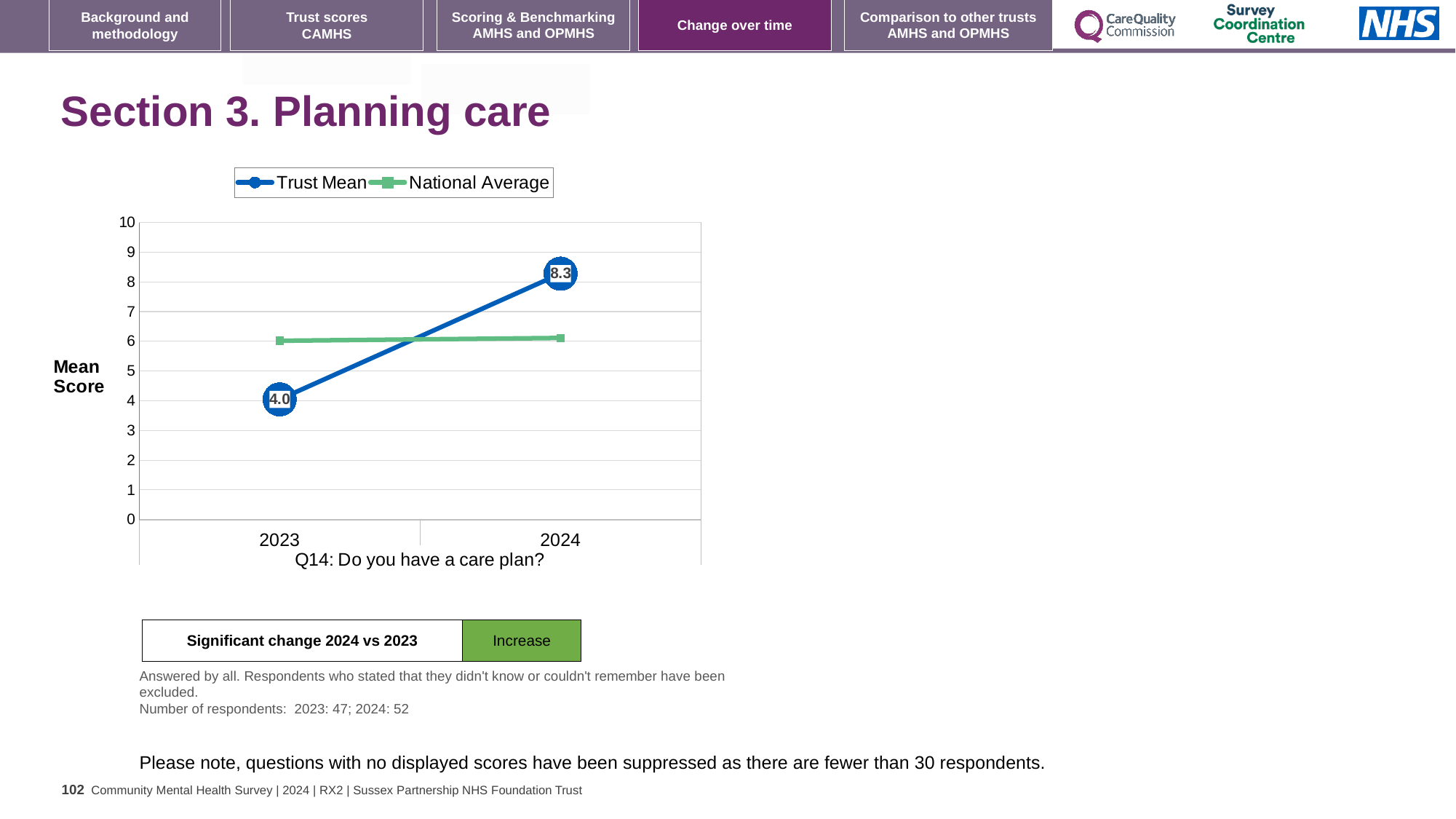
What kind of chart is shown on the slide? Line chart In 2023, which series is higher: Trust Mean or National Average? National Average How many series does the chart legend list? 2 Is the National Average value for 2023 greater or less than 7? less How many years are shown on the x axis of the chart? 2 Is the National Average value for 2024 greater or less than 5? greater Does the Trust Mean rise or fall from 2023 to 2024? Rise In 2024, which series is higher: Trust Mean or National Average? Trust Mean What is the Trust Mean value for 2023? 4.0 Which year has the higher Trust Mean, 2023 or 2024? 2024 By how much did the Trust Mean change from 2023 to 2024? 4.3 What is the Trust Mean value for 2024? 8.3